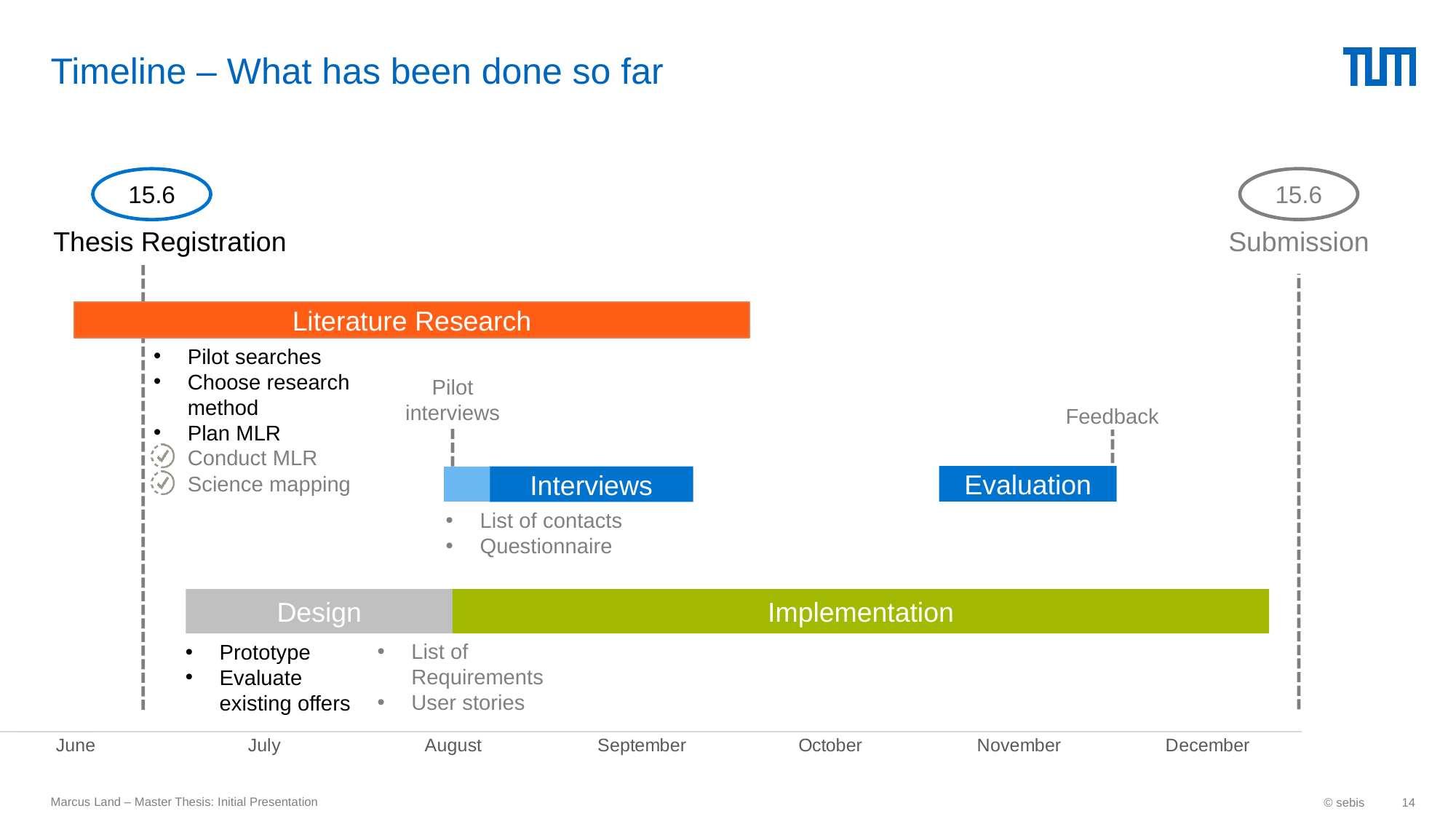
Which phase bar is longer, Evaluation or Literature Research? Literature Research Which phase bar starts earliest on the timeline? Literature Research What is the title of the slide? Timeline – What has been done so far What is the last month label on the horizontal axis? December What colour is the Literature Research bar? Orange Which phase bar spans the longest period on the timeline? Implementation How many phase bars are drawn on the timeline? 5 What date is shown in the circle above "Thesis Registration"? 15.6 What date is shown in the circle above "Submission"? 15.6 How many month labels are shown along the horizontal axis of the timeline? 7 Which phase bar is longer, Design or Implementation? Implementation What is the first month label on the horizontal axis? June